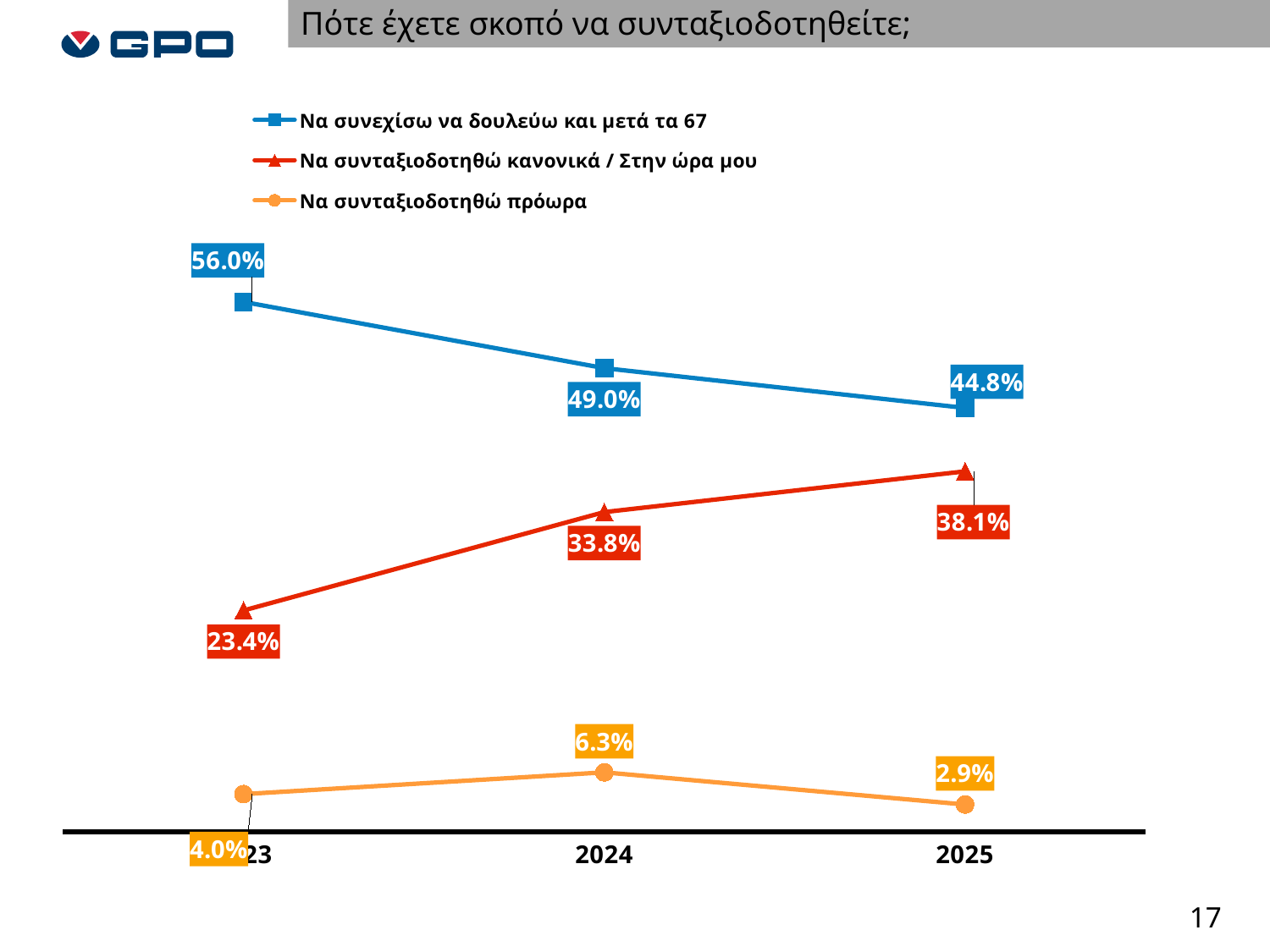
How many years are plotted on the x axis? 3 How many series does the legend list? 3 What is the value for 'Να συνταξιοδοτηθώ πρόωρα' in 2024? 6.3% In which year is the value for 'Να συνταξιοδοτηθώ πρόωρα' lowest? 2025 What is the value for 'Να συνεχίσω να δουλεύω και μετά τα 67' in 2024? 49.0% What is the value for 'Να συνταξιοδοτηθώ κανονικά / Στην ώρα μου' in 2025? 38.1% What is the value for 'Να συνεχίσω να δουλεύω και μετά τα 67' in 2025? 44.8% In which year is the value for 'Να συνταξιοδοτηθώ κανονικά / Στην ώρα μου' highest? 2025 What kind of chart is shown on the slide? line chart Which series has the larger value in 2024: 'Να συνταξιοδοτηθώ κανονικά / Στην ώρα μου' or 'Να συνταξιοδοτηθώ πρόωρα'? Να συνταξιοδοτηθώ κανονικά / Στην ώρα μου What is the difference between the 2025 values for 'Να συνεχίσω να δουλεύω και μετά τα 67' and 'Να συνταξιοδοτηθώ κανονικά / Στην ώρα μου'? 6.7% Does the value for 'Να συνεχίσω να δουλεύω και μετά τα 67' rise or fall from 2023 to 2025? fall